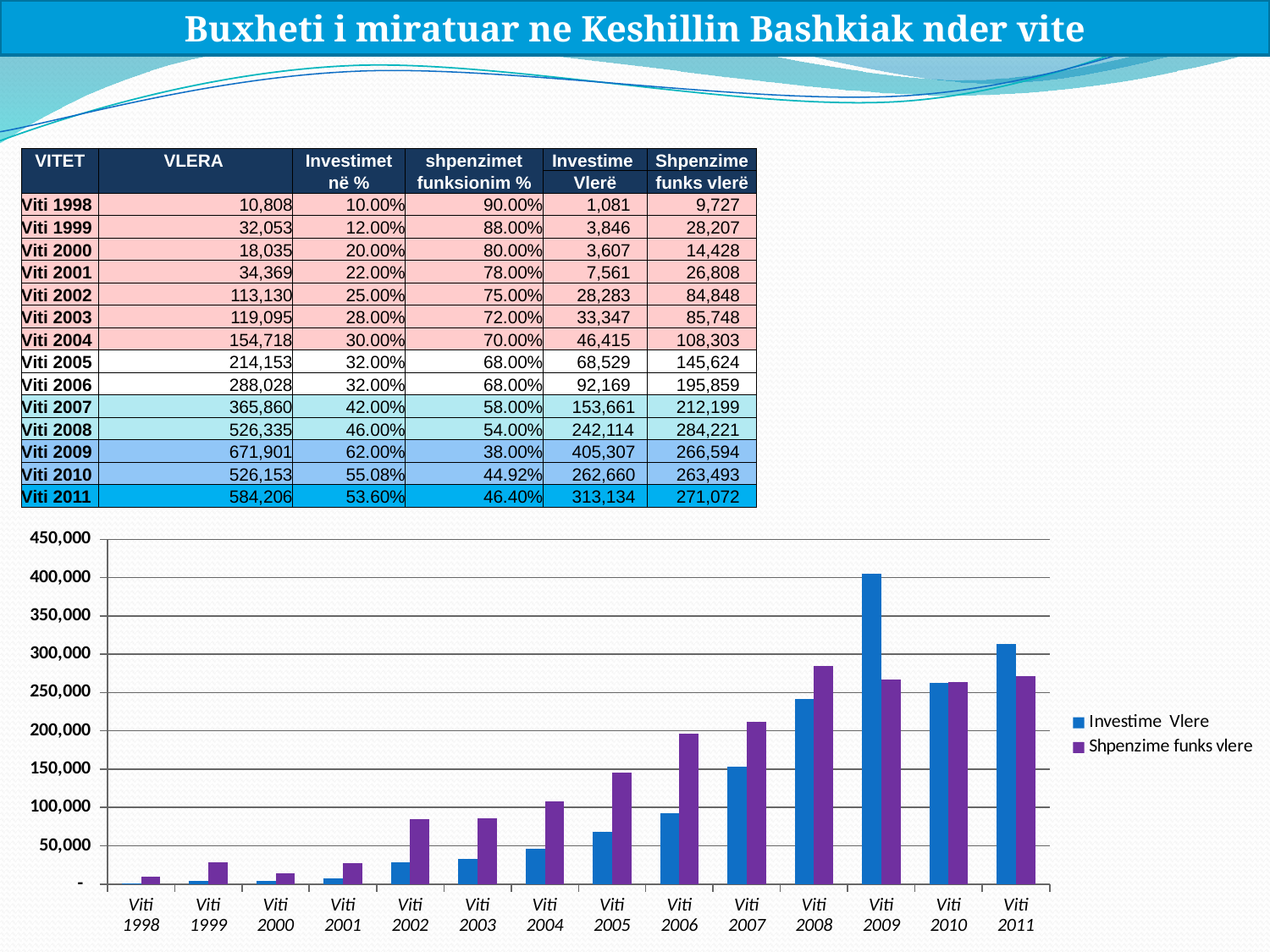
Is the Shpenzime funks vlere value for Viti 2007 greater or less than 200,000? greater What kind of chart is shown at the bottom of the slide? bar chart Is the Investime Vlere value for Viti 2009 greater or less than 400,000? greater Which year has the highest Investime Vlere bar in the chart? Viti 2009 For Viti 2008, which is larger in the chart: Investime Vlere or Shpenzime funks vlere? Shpenzime funks vlere For Viti 2009, which is larger in the chart: Investime Vlere or Shpenzime funks vlere? Investime Vlere Which year has the lowest Shpenzime funks vlere bar in the chart? Viti 1998 Using the table values, what is the difference between Investime Vlerë and Shpenzime funks vlerë for Viti 2009? 138,713 According to the table, what is the Investime Vlerë value for Viti 2011? 313,134 How many years (categories) are plotted along the x axis of the chart? 14 Do the Investime Vlere bars rise or fall from Viti 2001 to Viti 2009? rise How many series does the chart's legend list? 2